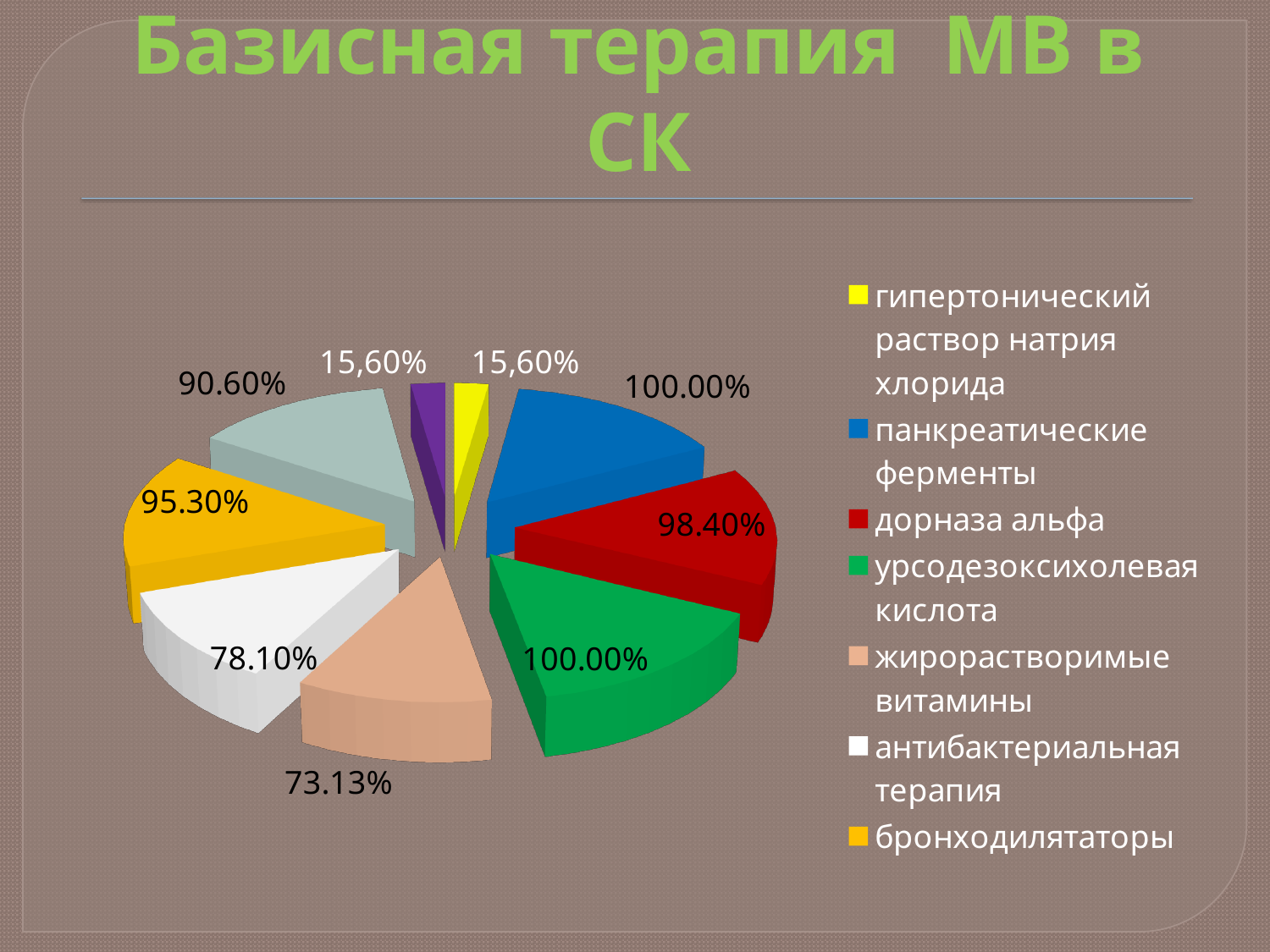
What value is shown for антибактериальная терапия? 78.10% What value is shown for панкреатические ферменты? 100.00% What value is shown for гипертонический раствор натрия хлорида? 15,60% What kind of chart is shown on the slide? pie chart How many entries does the legend list? 7 What is the difference between the value for антибактериальная терапия and the value for жирорастворимые витамины? 4.97% What value is shown for жирорастворимые витамины? 73.13% What value is shown for бронходилятаторы? 95.30% Which is larger, the value for дорназа альфа or the value for бронходилятаторы? дорназа альфа How many slices does the pie chart have? 9 What is the title of the chart slide? Базисная терапия МВ в СК What value is shown for дорназа альфа? 98.40%